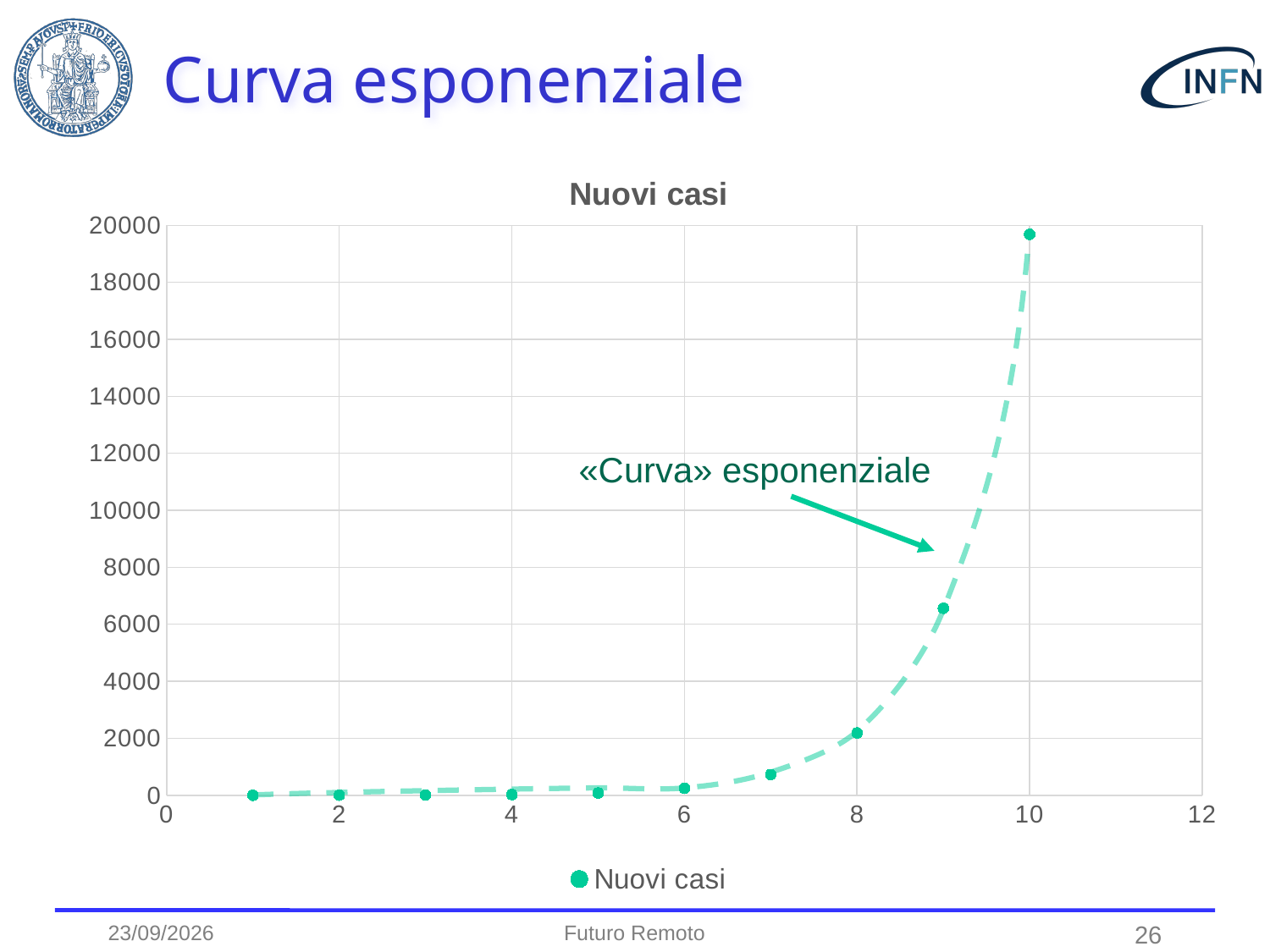
Which has the larger value, the point at x = 9 or the point at x = 10? x = 10 How many data points are plotted in the chart? 10 Do the values rise or fall as x increases along the x axis? rise Is the value at x = 8 greater or less than 4000? less What is the title of the chart? Nuovi casi Is the value at x = 10 greater or less than 18000? greater What kind of chart is shown on the slide? scatter chart At which x value is the plotted value highest? 10 How many series does the legend list? 1 Is the value at x = 9 greater or less than 8000? less What text does the annotation with the arrow pointing at the curve say? «Curva» esponenziale